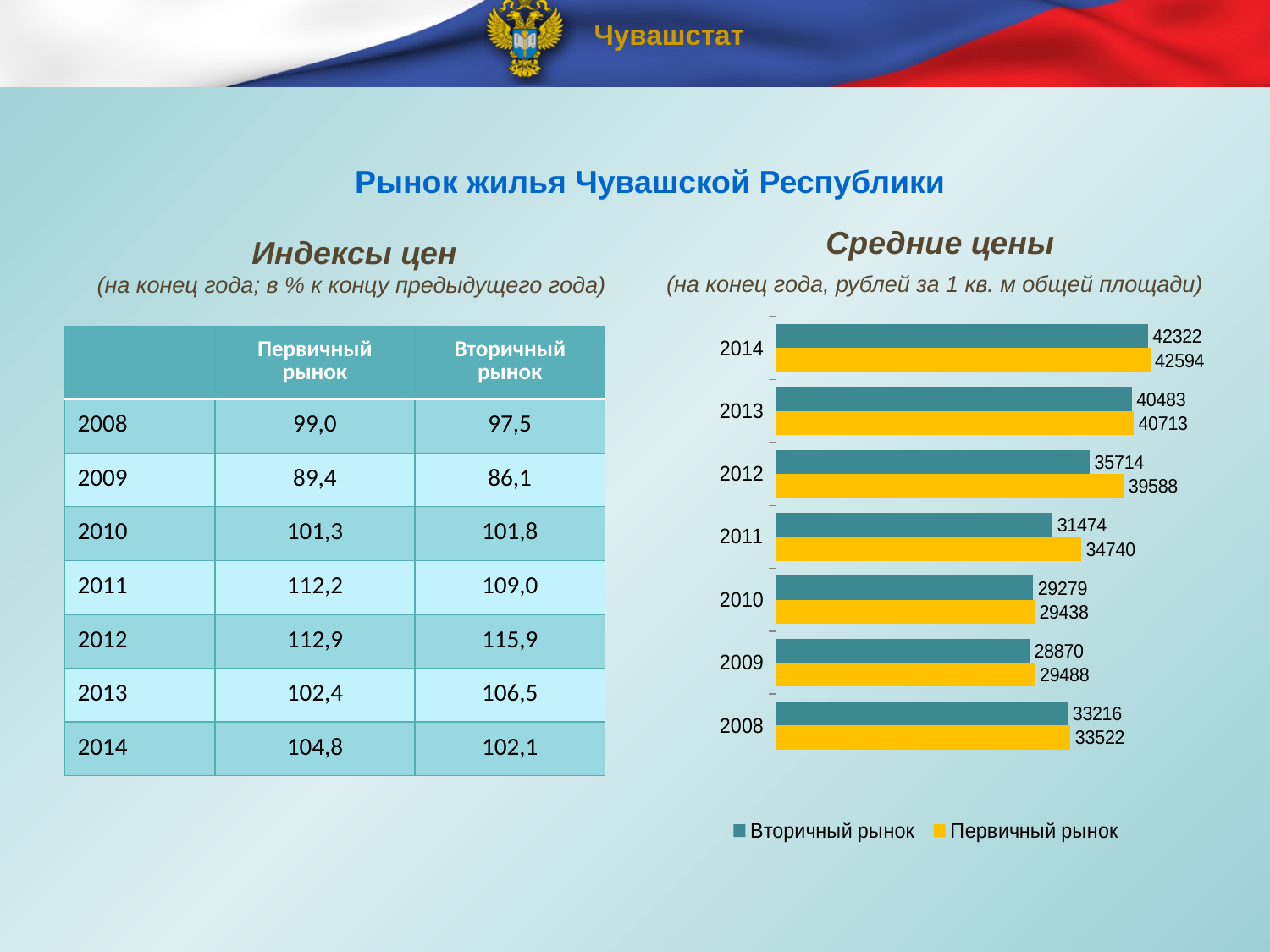
In the "Средние цены" chart, which is larger in 2011: Первичный рынок or Вторичный рынок? Первичный рынок What type of chart is "Средние цены"? Bar chart In the "Средние цены" chart, what is the difference between the Первичный рынок values for 2014 and 2013? 1881 In the "Средние цены" chart, how many years are shown? 7 In the "Средние цены" chart, which year has the highest value for Первичный рынок? 2014 In the "Средние цены" chart, what is the value for Первичный рынок in 2014? 42594 In the "Средние цены" chart, what is the value for Вторичный рынок in 2009? 28870 In the "Средние цены" chart, what is the difference between Первичный рынок and Вторичный рынок in 2012? 3874 In the "Средние цены" chart, what is the value for Вторичный рынок in 2012? 35714 In the "Средние цены" chart, how many series does the legend list? 2 In the "Средние цены" chart, which year has the lowest value for Вторичный рынок? 2009 In the "Средние цены" chart, which colour represents Первичный рынок? Yellow